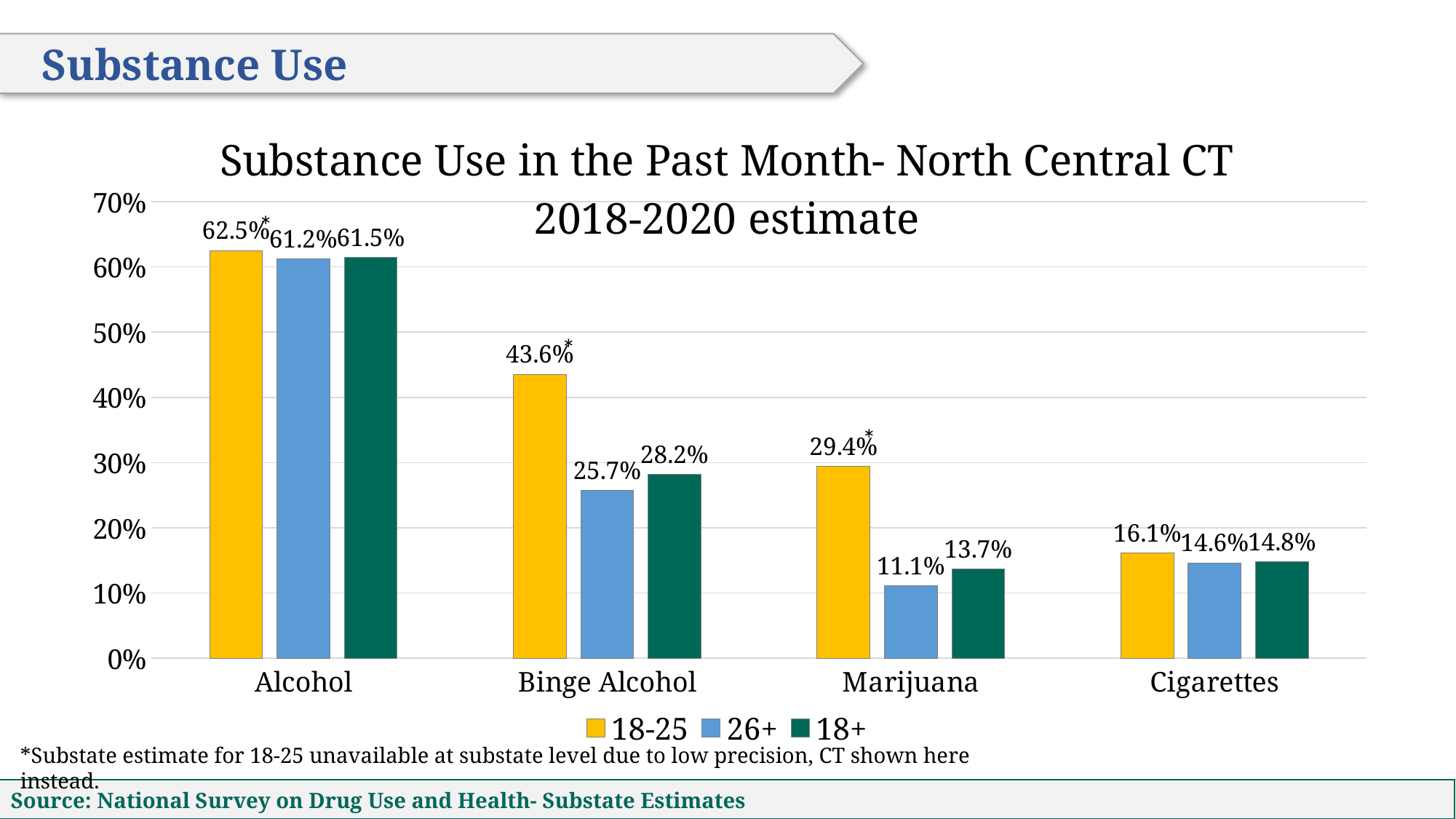
Which category has the highest value for the 26+ series? Alcohol How many series does the legend list? 3 Which is larger for Alcohol: the 26+ value or the 18+ value? 18+ What is the difference between the 18+ and 26+ values for Marijuana? 2.6% Which category has the lowest value for the 18-25 series? Cigarettes Is the value for the 18+ series for Binge Alcohol greater or less than 30%? less What is the difference between the 18-25 and 26+ values for Binge Alcohol? 17.9% How many categories are shown on the x axis? 4 What kind of chart is shown on the slide? Bar chart What is the value for the 18+ series for Cigarettes? 14.8% What is the value for the 26+ series for Marijuana? 11.1% What is the value for the 18-25 series for Binge Alcohol? 43.6%